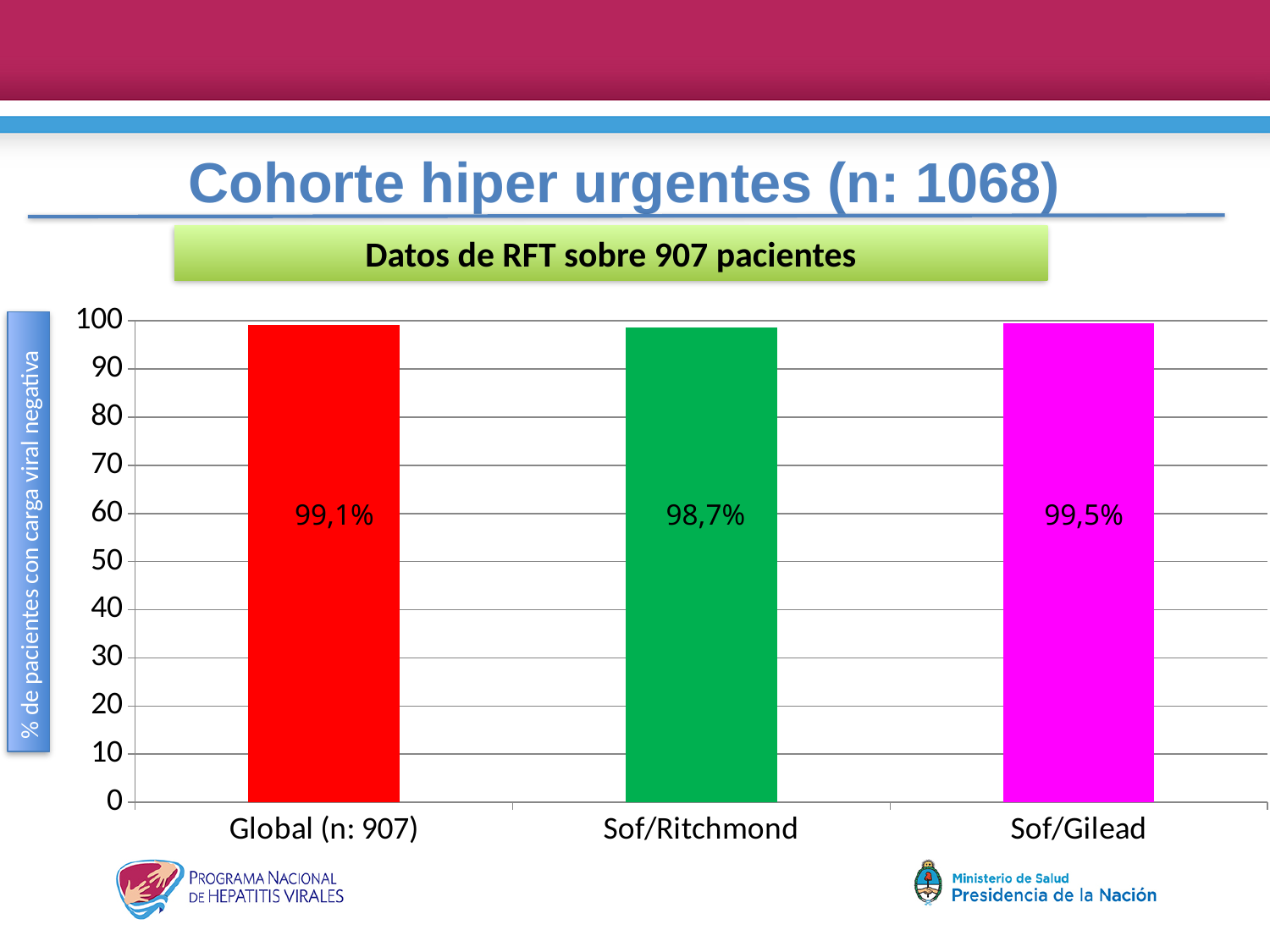
What is the difference between the values for Global (n: 907) and Sof/Ritchmond? 0,4% How many categories are shown on the x axis? 3 What is the value for Sof/Ritchmond? 98,7% Which category has the highest value? Sof/Gilead What is the value for Sof/Gilead? 99,5% What kind of chart is shown on the slide? bar chart What is the difference between the values for Sof/Gilead and Sof/Ritchmond? 0,8% Which is larger, the value for Sof/Gilead or the value for Global (n: 907)? Sof/Gilead Which category has the lowest value? Sof/Ritchmond What is the label of the y axis? % de pacientes con carga viral negativa What is the value for Global (n: 907)? 99,1% Is the value for Sof/Ritchmond greater or less than 90? greater